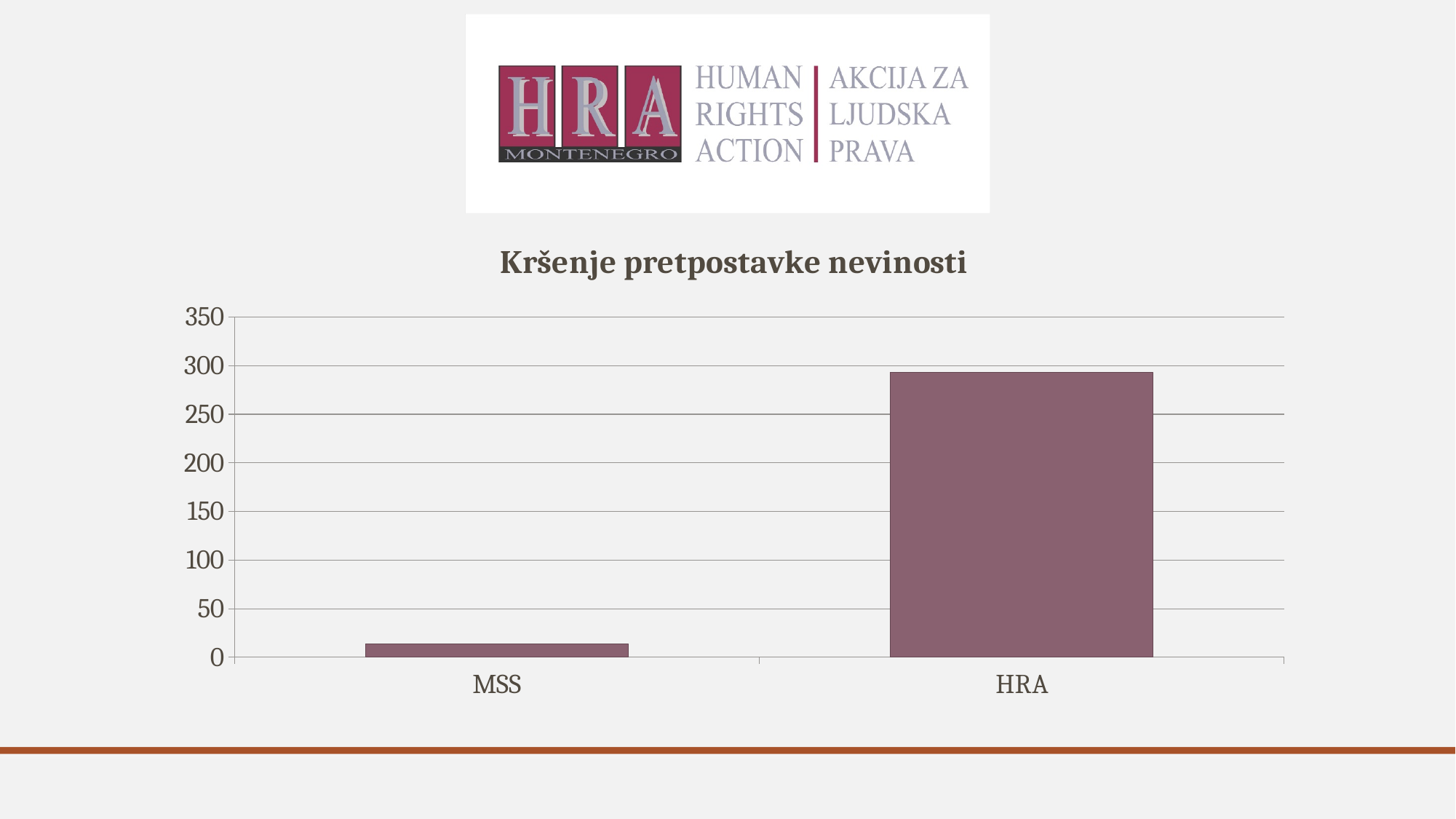
What is the highest value shown on the y axis of the chart? 350 Which category has the lowest value in the chart? MSS What kind of chart is shown on the slide? bar chart Is the value for HRA greater or less than 250? greater Which category has the highest value in the chart? HRA How many categories are shown on the x axis of the chart? 2 Which is larger, the value for MSS or the value for HRA? HRA What is the title of the chart? Kršenje pretpostavke nevinosti Is the value for MSS greater or less than 50? less Is the value for HRA greater or less than 300? less